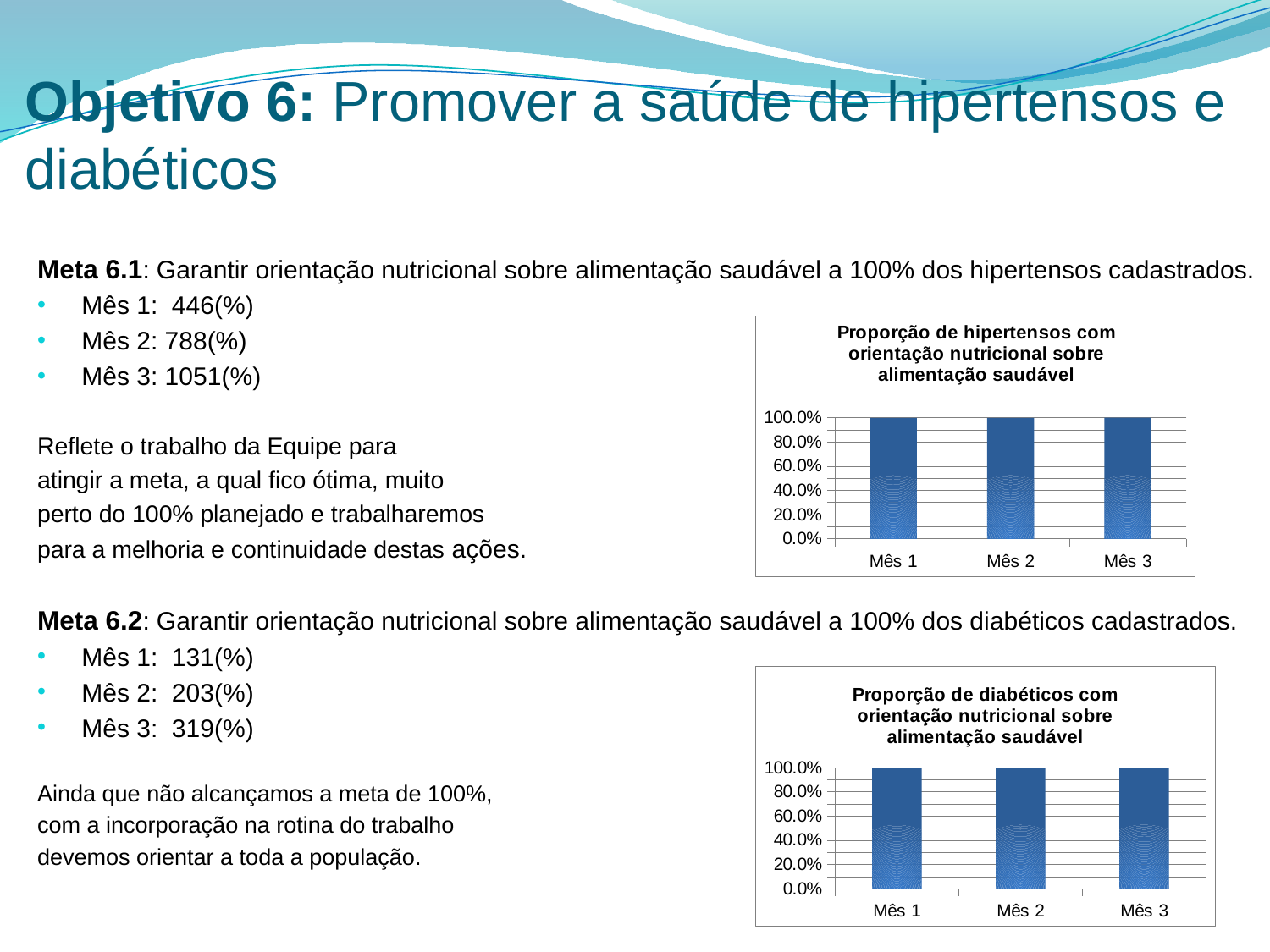
What kind of chart is the 'Proporção de diabéticos com orientação nutricional sobre alimentação saudável' chart? bar chart In the 'Proporção de diabéticos com orientação nutricional sobre alimentação saudável' chart, is the value for Mês 1 greater or less than 80.0%? greater What is the label of the first category on the x axis of the 'Proporção de diabéticos com orientação nutricional sobre alimentação saudável' chart? Mês 1 In the 'Proporção de hipertensos com orientação nutricional sobre alimentação saudável' chart, is the value for Mês 2 greater or less than 60.0%? greater In the 'Proporção de diabéticos com orientação nutricional sobre alimentação saudável' chart, how many bars are plotted? 3 In the 'Proporção de diabéticos com orientação nutricional sobre alimentação saudável' chart, what is the highest value shown on the y axis? 100.0% What kind of chart is the 'Proporção de hipertensos com orientação nutricional sobre alimentação saudável' chart? bar chart In the 'Proporção de hipertensos com orientação nutricional sobre alimentação saudável' chart, how many categories are shown on the x axis? 3